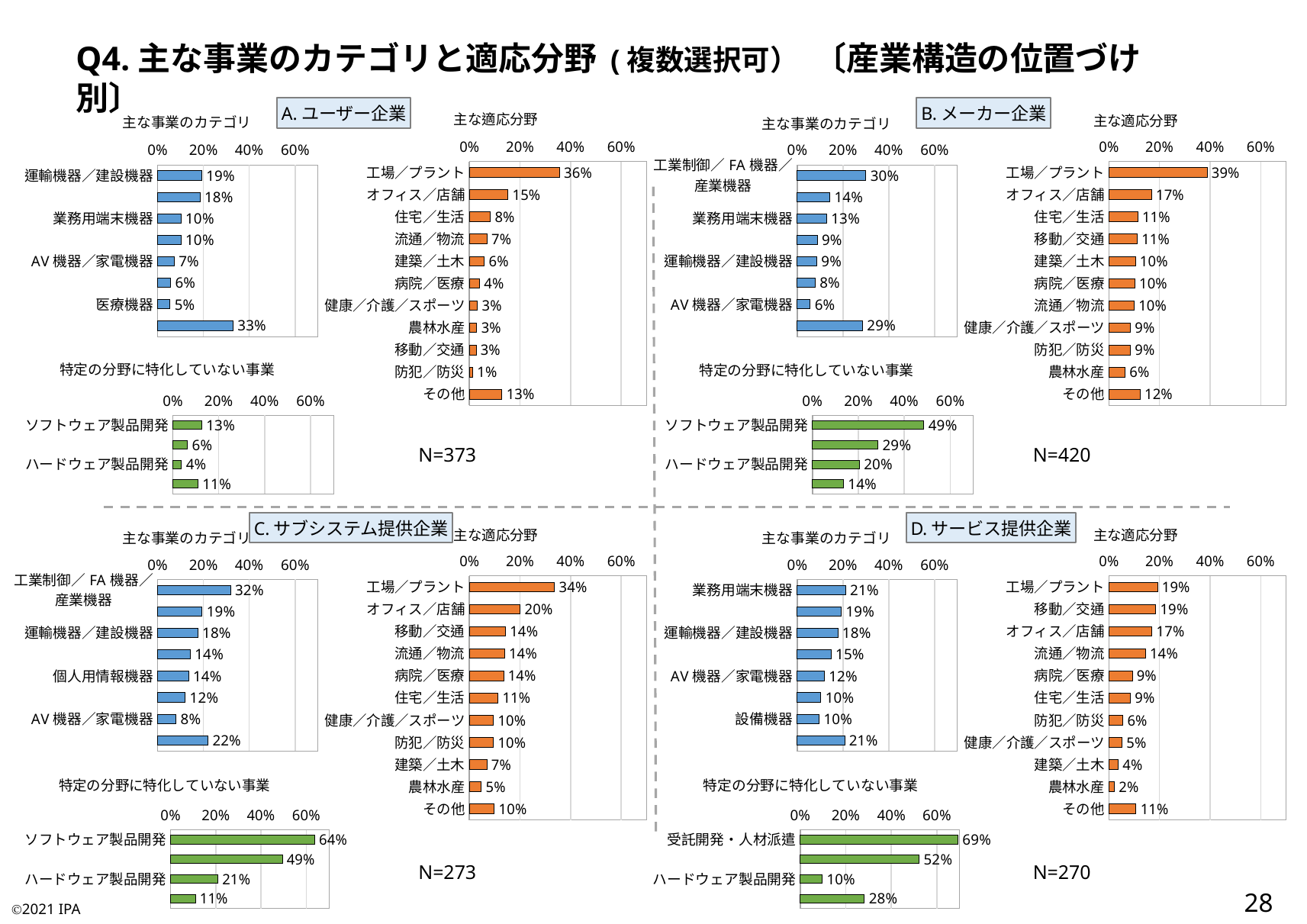
In the B. メーカー企業 主な適応分野 chart, what is the difference between 工場／プラント and オフィス／店舗? 22% In the A. ユーザー企業 主な適応分野 chart, which category has the lowest value? 防犯／防災 In the D. サービス提供企業 特定の分野に特化していない事業 chart, what is the value for 受託開発・人材派遣? 69% In the C. サブシステム提供企業 主な適応分野 chart, which category has the highest value? 工場／プラント In the C. サブシステム提供企業 特定の分野に特化していない事業 chart, is the value for ソフトウェア製品開発 greater or less than 60%? greater In the D. サービス提供企業 主な適応分野 chart, which is larger, オフィス／店舗 or 流通／物流? オフィス／店舗 What kind of chart is the A. ユーザー企業 主な事業のカテゴリ chart? bar chart In the C. サブシステム提供企業 主な事業のカテゴリ chart, what is the value for 運輸機器／建設機器? 18% What is the N value shown for the D. サービス提供企業 section? N=270 In the B. メーカー企業 主な事業のカテゴリ chart, what is the value for 工業制御／FA機器／産業機器? 30% How many categories are shown in the B. メーカー企業 主な適応分野 chart? 11 In the A. ユーザー企業 主な適応分野 chart, what is the value for 工場／プラント? 36%